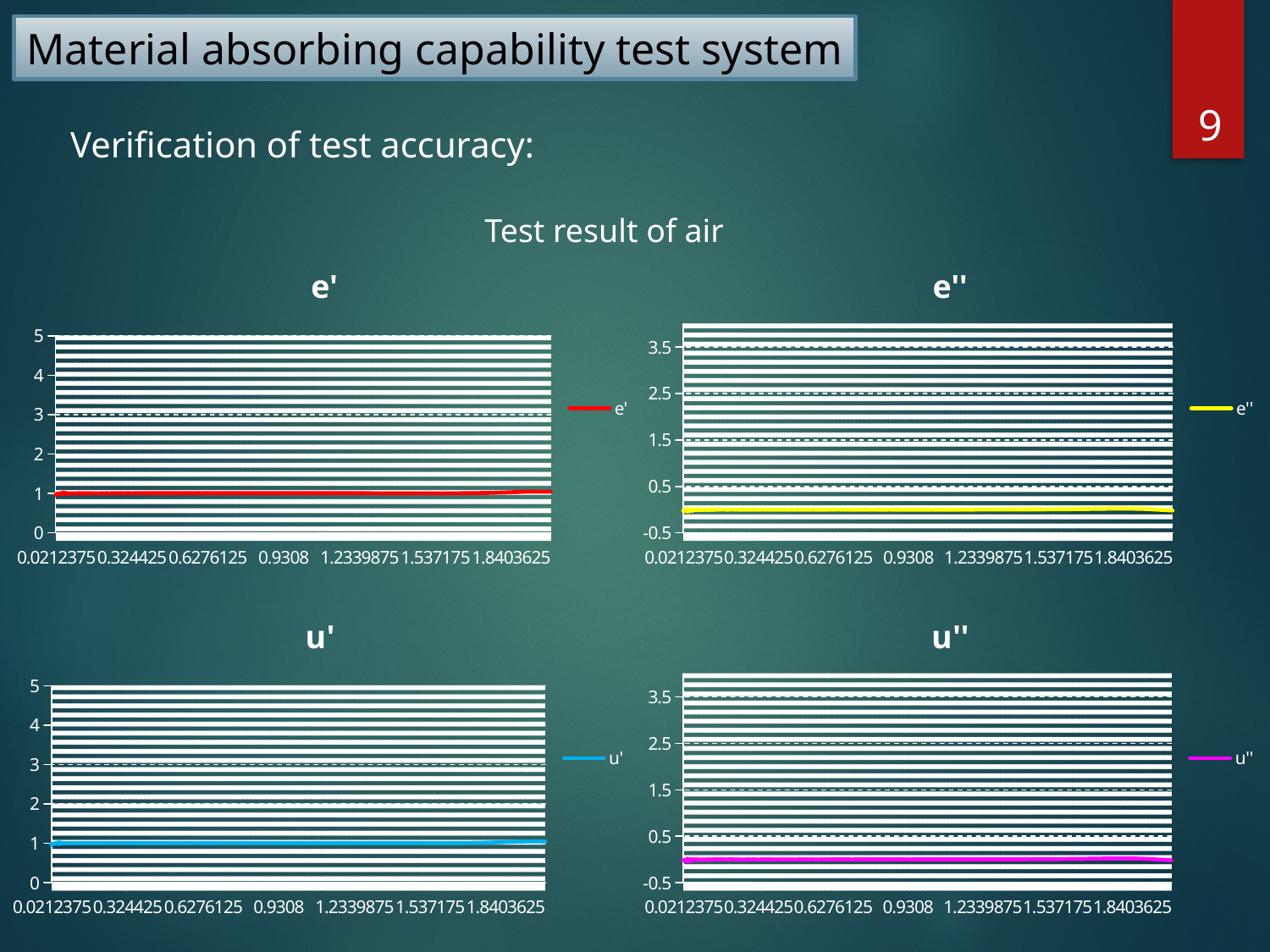
How many series does the legend of the u' chart list? 1 In the e' chart, is the plotted value at x = 0.9308 greater or less than 2? less What colour is the line in the u'' chart? magenta In the e'' chart, is the plotted value at x = 0.6276125 greater or less than 0.5? less How many charts are shown on the slide? 4 In the e' chart, is the plotted value at x = 0.324425 greater or less than 0? greater How many x-axis tick labels are shown on the u' chart? 7 What kind of chart is the e' chart? line chart What is the lowest tick label on the y axis of the u'' chart? -0.5 What is the highest tick label on the y axis of the e'' chart? 3.5